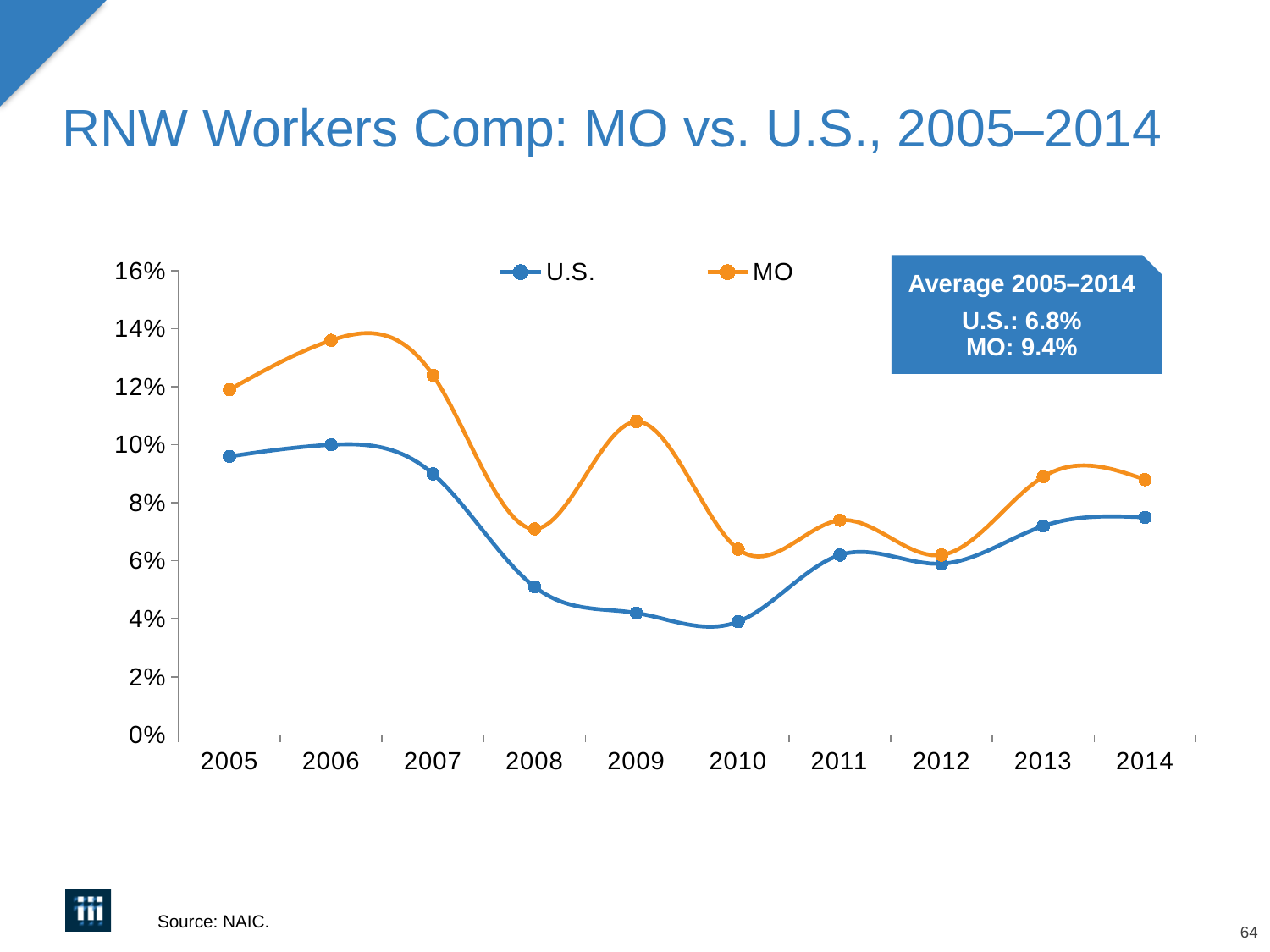
Is the value for MO in 2013 greater or less than 8%? greater Is the value for U.S. in 2008 greater or less than 6%? less How many series does the legend list? 2 What is the average RNW for the U.S. over 2005–2014, as shown in the text box? 6.8% What is the average RNW for MO over 2005–2014, as shown in the text box? 9.4% What kind of chart is shown on the slide? line chart Does the U.S. series rise or fall from 2006 to 2010? fall In which year does the MO series reach its highest value? 2006 Is the value for MO in 2005 greater or less than 10%? greater In which year does the U.S. series reach its lowest value? 2010 In 2009, which series has the larger value, U.S. or MO? MO How many years are plotted along the x axis? 10